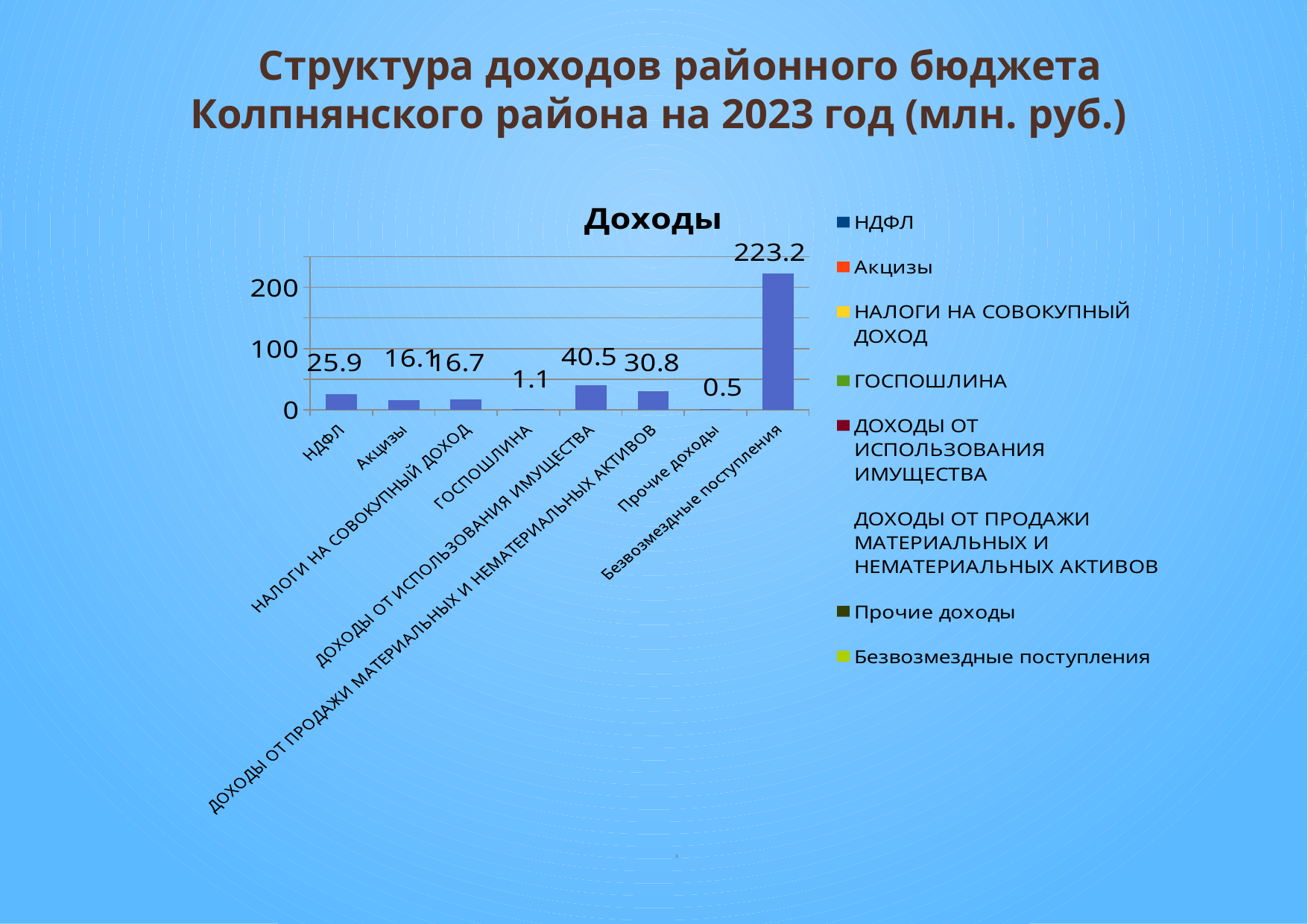
Which is larger, the value for НДФЛ or the value for Акцизы? НДФЛ Which category has the lowest value? Прочие доходы How many categories are shown on the x axis of the chart? 8 What is the difference between the values for ДОХОДЫ ОТ ИСПОЛЬЗОВАНИЯ ИМУЩЕСТВА and ДОХОДЫ ОТ ПРОДАЖИ МАТЕРИАЛЬНЫХ И НЕМАТЕРИАЛЬНЫХ АКТИВОВ? 9.7 Is the value for Безвозмездные поступления greater or less than 200? greater What is the title of the chart? Доходы What is the value for Безвозмездные поступления? 223.2 What is the value for НДФЛ? 25.9 What type of chart is shown on the slide? bar chart What is the value for ДОХОДЫ ОТ ИСПОЛЬЗОВАНИЯ ИМУЩЕСТВА? 40.5 Which category has the highest value? Безвозмездные поступления What is the value for Прочие доходы? 0.5